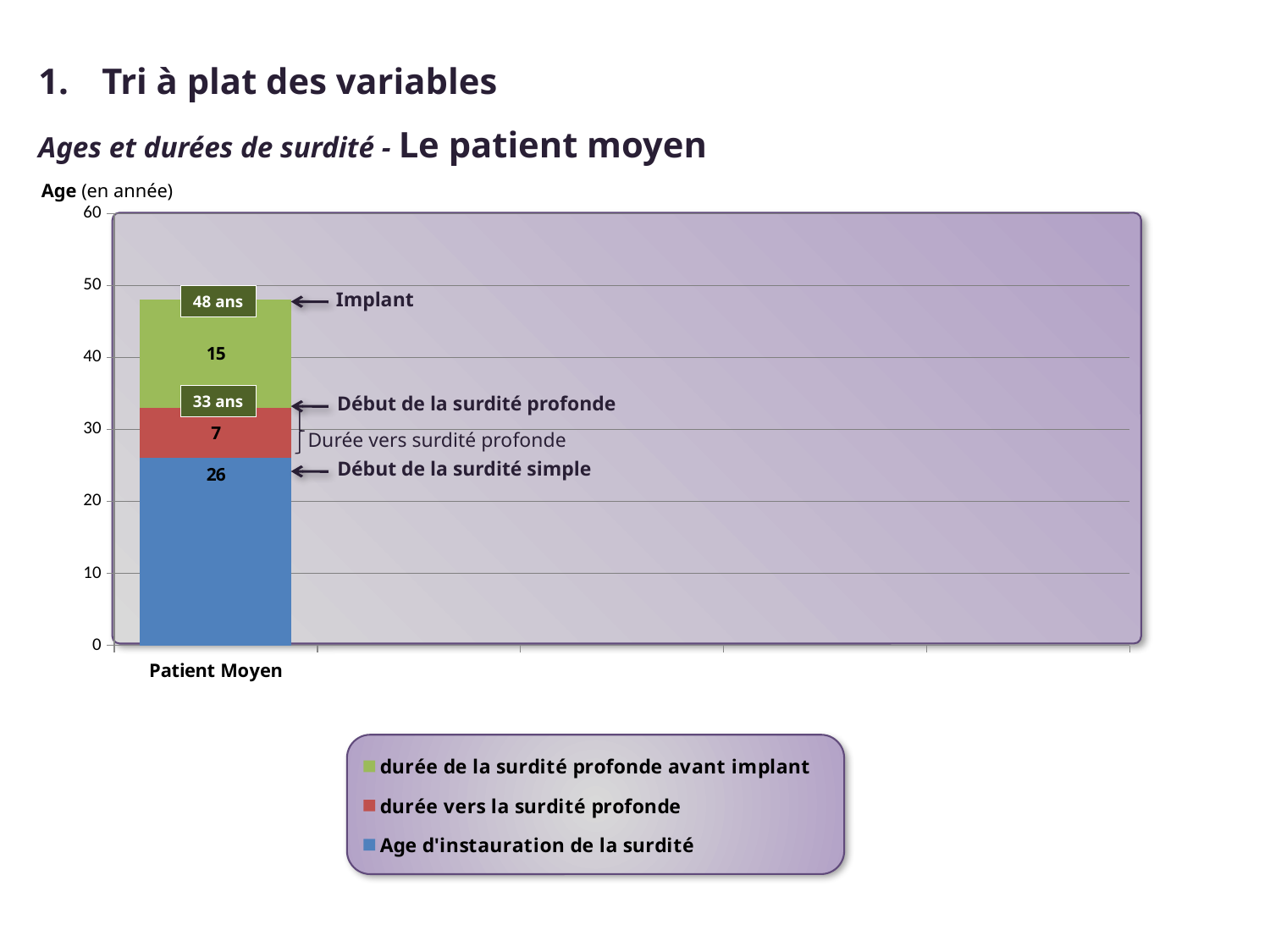
What is the difference between the 'Age d'instauration de la surdité' segment and the 'durée de la surdité profonde avant implant' segment? 11 What is the value of the 'durée de la surdité profonde avant implant' segment for Patient Moyen? 15 What is the value of the 'durée vers la surdité profonde' segment for Patient Moyen? 7 At what age does the annotation 'Implant' point to on the bar? 48 ans Which segment of the Patient Moyen bar has the smallest value? durée vers la surdité profonde Which segment of the Patient Moyen bar has the largest value? Age d'instauration de la surdité What kind of chart is shown on the slide? Stacked bar chart How many categories are shown on the x axis? 1 What is the total height of the stacked bar for Patient Moyen? 48 How many series does the legend list? 3 Which is larger: the 'durée de la surdité profonde avant implant' segment or the 'durée vers la surdité profonde' segment? durée de la surdité profonde avant implant What is the value of the 'Age d'instauration de la surdité' segment for Patient Moyen? 26